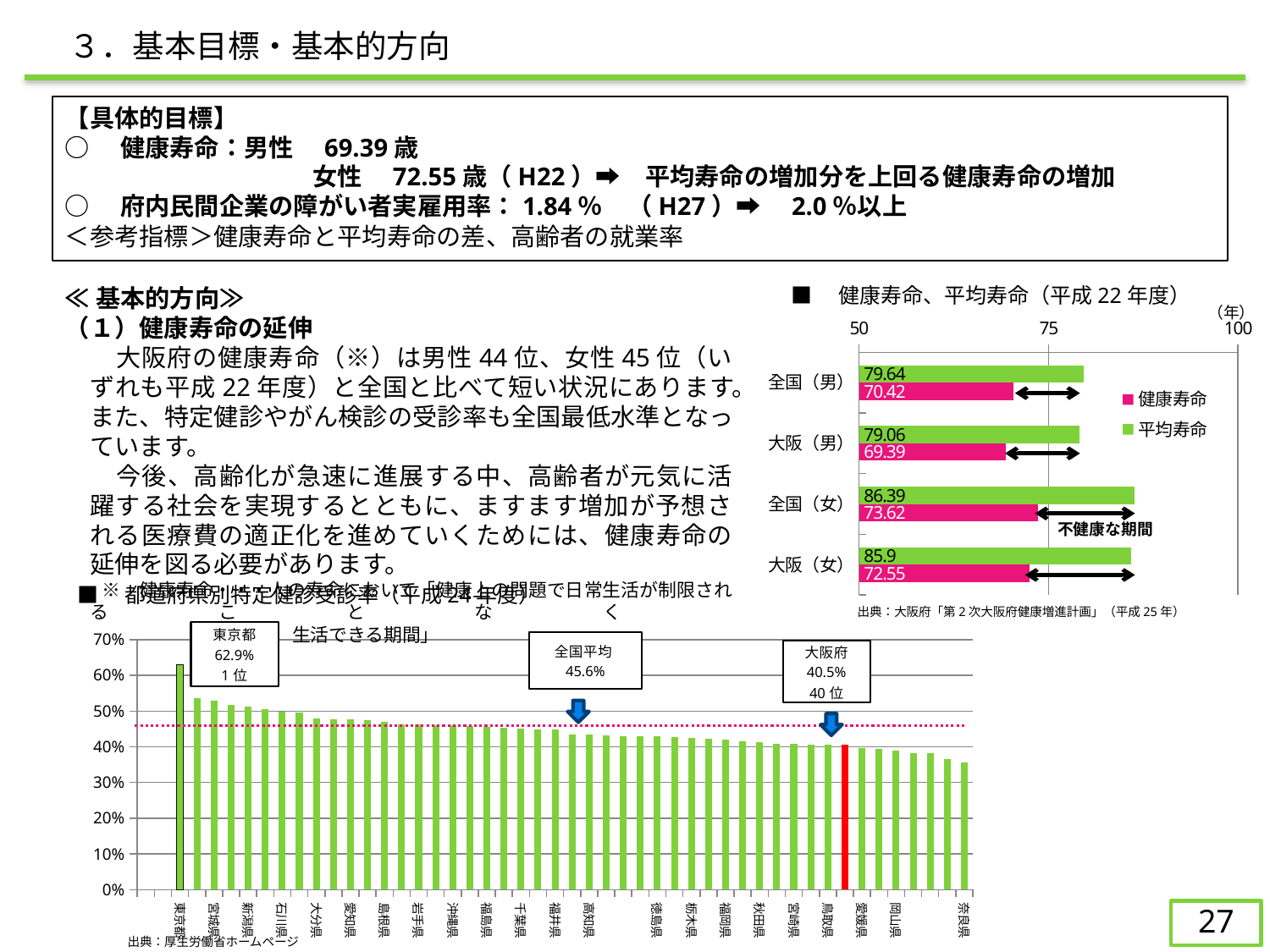
In the chart titled 健康寿命、平均寿命（平成22年度）, what is the 平均寿命 value for 全国（女）? 86.39 In the chart titled 健康寿命、平均寿命（平成22年度）, what is the 平均寿命 value for 大阪（女）? 85.9 In the chart titled 都道府県別特定健診受診率（平成24年度）, what is the 全国平均 value shown? 45.6% In the chart titled 都道府県別特定健診受診率（平成24年度）, what is the value for 大阪府? 40.5% In the chart titled 健康寿命、平均寿命（平成22年度）, what is the 健康寿命 value for 大阪（男）? 69.39 In the chart titled 健康寿命、平均寿命（平成22年度）, which category has the lowest 健康寿命? 大阪（男） In the chart titled 健康寿命、平均寿命（平成22年度）, what is the difference between 平均寿命 and 健康寿命 for 全国（男）? 9.22 In the chart titled 健康寿命、平均寿命（平成22年度）, which category has the highest 平均寿命? 全国（女） In the chart titled 健康寿命、平均寿命（平成22年度）, which colour represents 健康寿命? Pink In the chart titled 都道府県別特定健診受診率（平成24年度）, what is the value for 東京都? 62.9% In the chart titled 健康寿命、平均寿命（平成22年度）, how many series does the legend list? 2 In the chart titled 都道府県別特定健診受診率（平成24年度）, what kind of chart is it? Bar chart